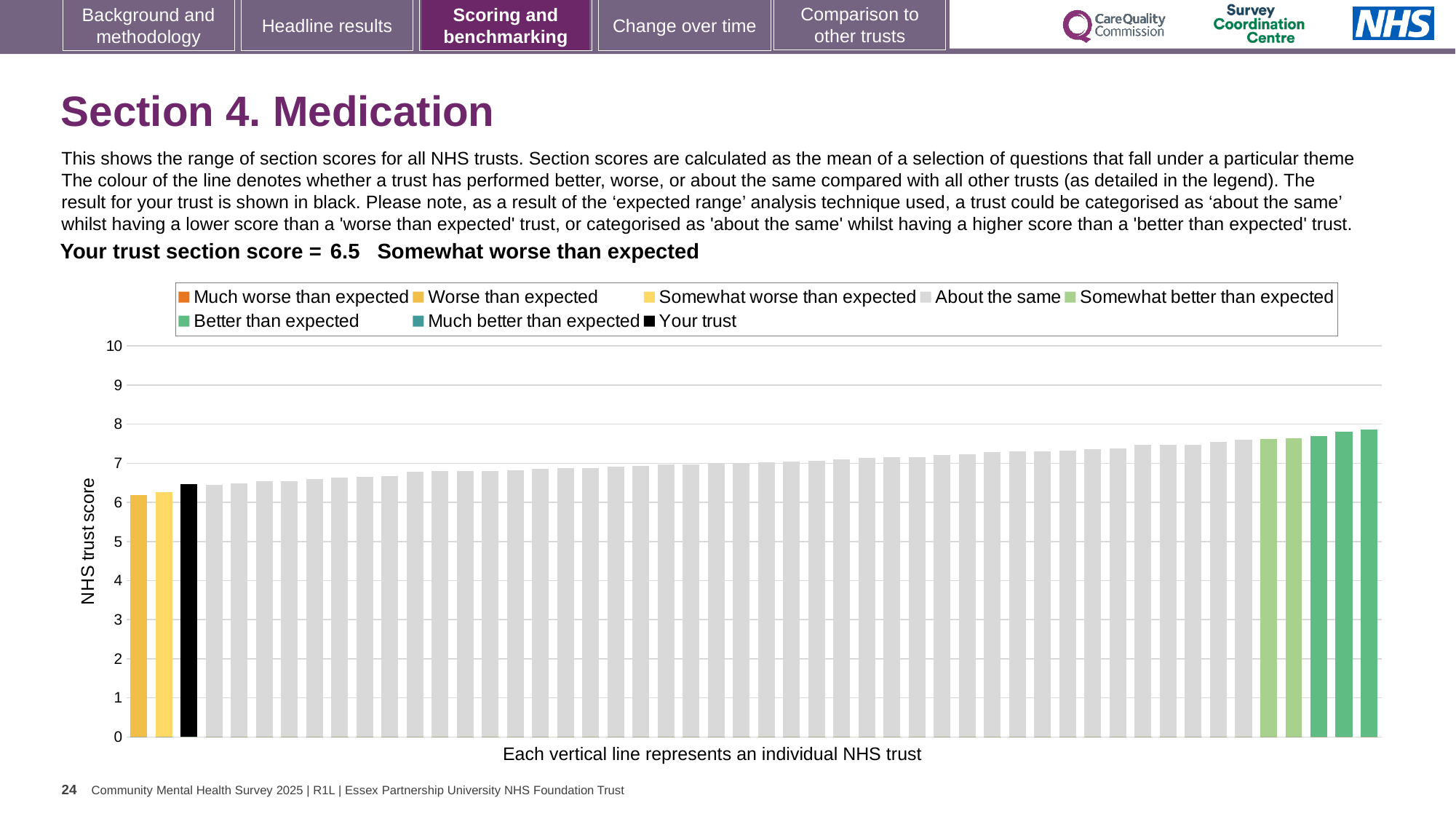
Is the value for your trust (the black bar) greater or less than 6? greater How many bars are coloured as 'Somewhat better than expected'? 2 Do the bar values rise or fall from left to right along the x axis? rise Is the value for your trust (the black bar) greater or less than 7? less Which category is your trust's section score placed in? Somewhat worse than expected What is the label on the vertical axis of the chart? NHS trust score What is the section score for your trust shown on the slide? 6.5 What kind of chart is shown on the slide? bar chart Is the value of the lowest bar greater or less than 6? greater How many bars are coloured as 'Better than expected'? 3 How many entries does the chart legend list? 8